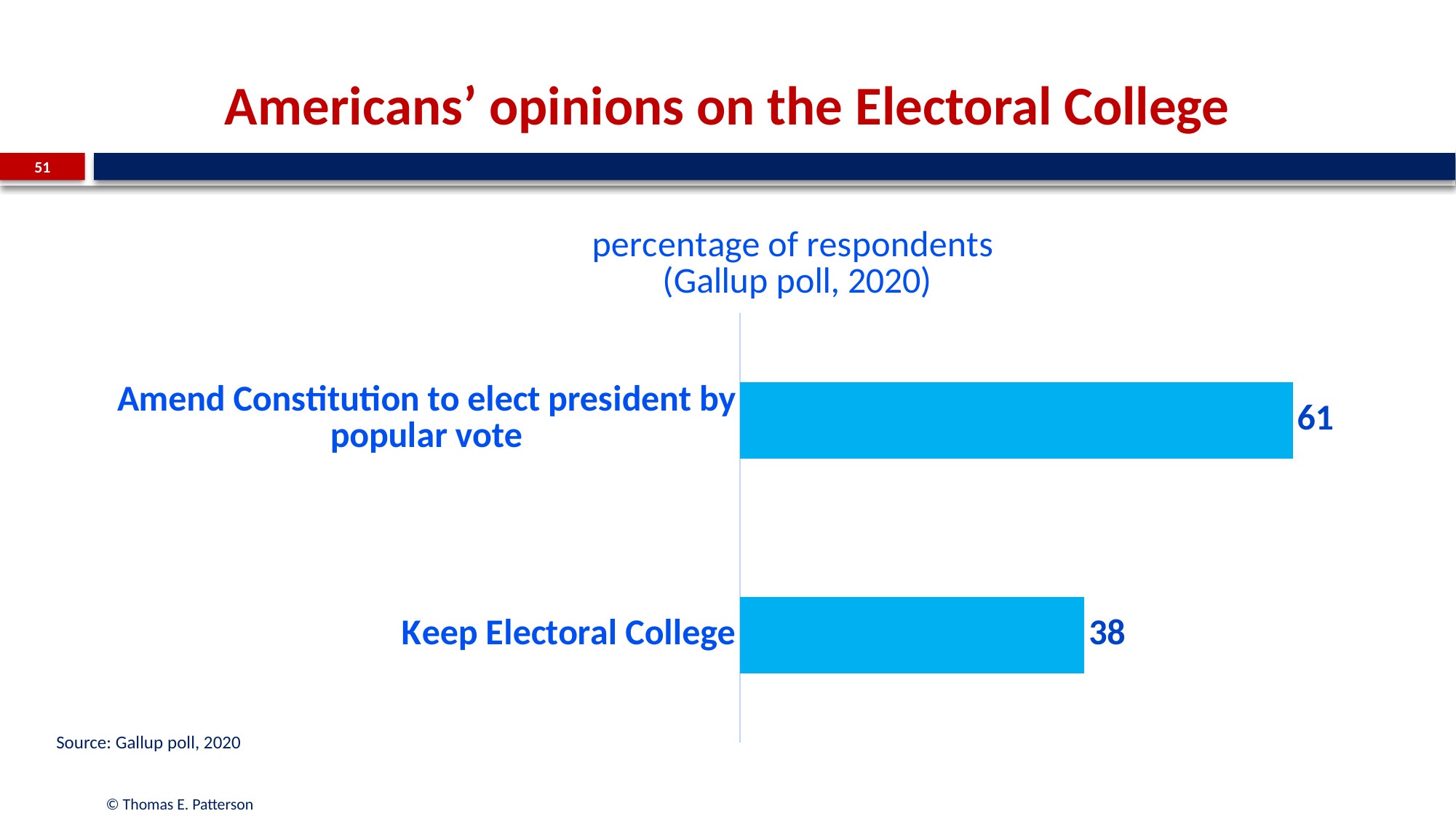
What is the difference in percentage points between those who favor amending the Constitution and those who favor keeping the Electoral College? 23 What percentage of respondents favor amending the Constitution to elect the president by popular vote? 61 Is the value for Keep Electoral College larger or smaller than the value for Amend Constitution to elect president by popular vote? smaller How many categories are shown in the chart? 2 What percentage of respondents favor keeping the Electoral College? 38 What is the title of the chart? percentage of respondents (Gallup poll, 2020) What is the source of the data shown in the chart? Gallup poll, 2020 Which option has the lower percentage of respondents? Keep Electoral College What kind of chart is shown on the slide? bar chart Which option has the higher percentage of respondents? Amend Constitution to elect president by popular vote